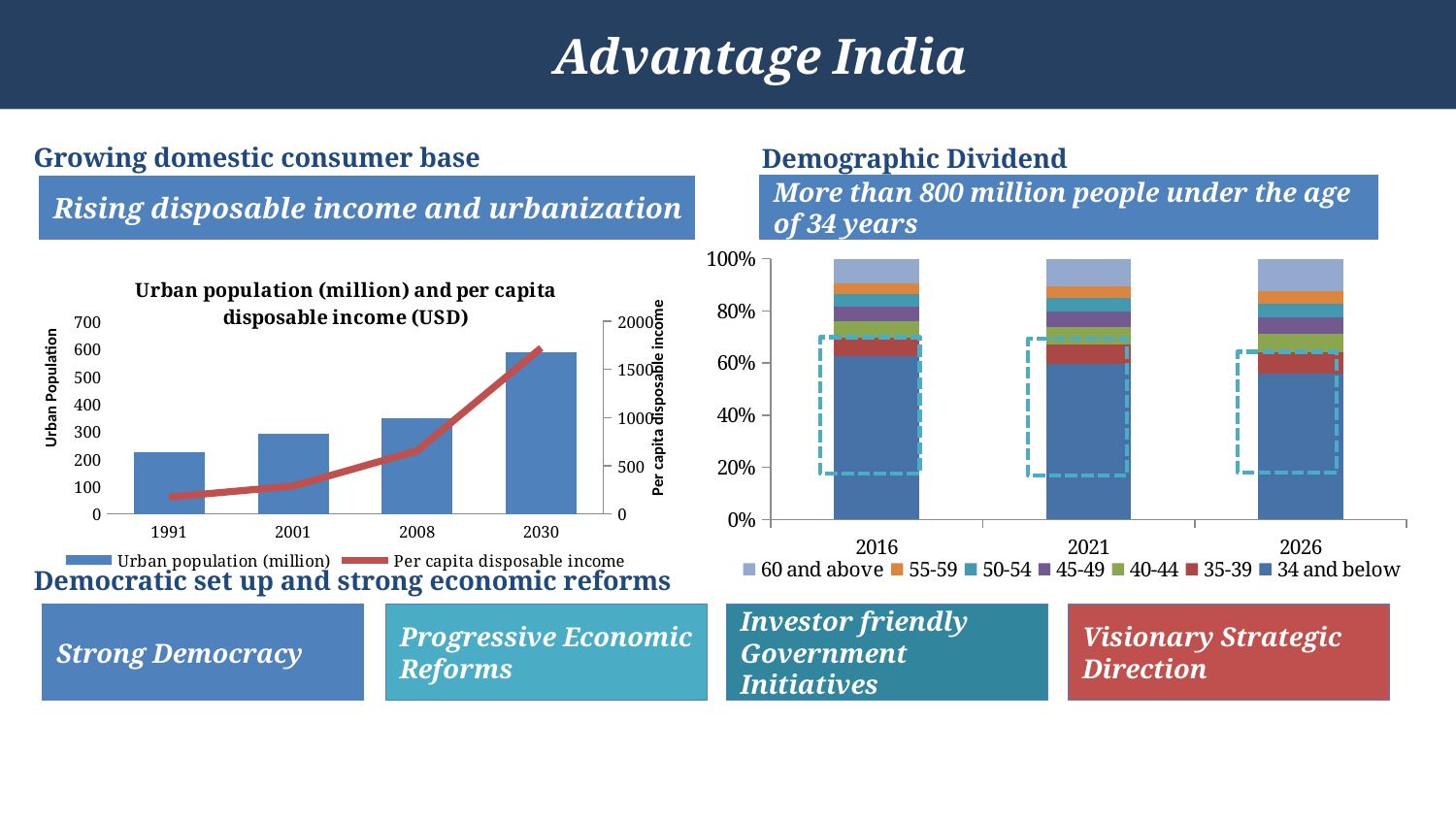
What kind of chart is the chart on the right under 'Demographic Dividend'? A stacked bar chart In the 'Urban population (million) and per capita disposable income (USD)' chart, is the urban population for 2030 greater or less than 500? greater In the 'Urban population (million) and per capita disposable income (USD)' chart, which year has the lowest urban population bar? 1991 In the 'Urban population (million) and per capita disposable income (USD)' chart, which year has the highest urban population bar? 2030 How many series does the legend of the 'Urban population (million) and per capita disposable income (USD)' chart list? 2 How many age groups does the legend of the stacked bar chart on the right list? 7 What kind of chart is the 'Urban population (million) and per capita disposable income (USD)' chart on the left? A bar chart combined with a line chart In the stacked bar chart on the right, is the share of '34 and below' in 2016 greater or less than 40%? greater How many years are shown on the x axis of the 'Urban population (million) and per capita disposable income (USD)' chart? 4 How many years are shown on the x axis of the stacked bar chart on the right? 3 In the 'Urban population (million) and per capita disposable income (USD)' chart, is the urban population for 1991 greater or less than 300? less In the 'Urban population (million) and per capita disposable income (USD)' chart, does the per capita disposable income line rise or fall from 1991 to 2030? rise